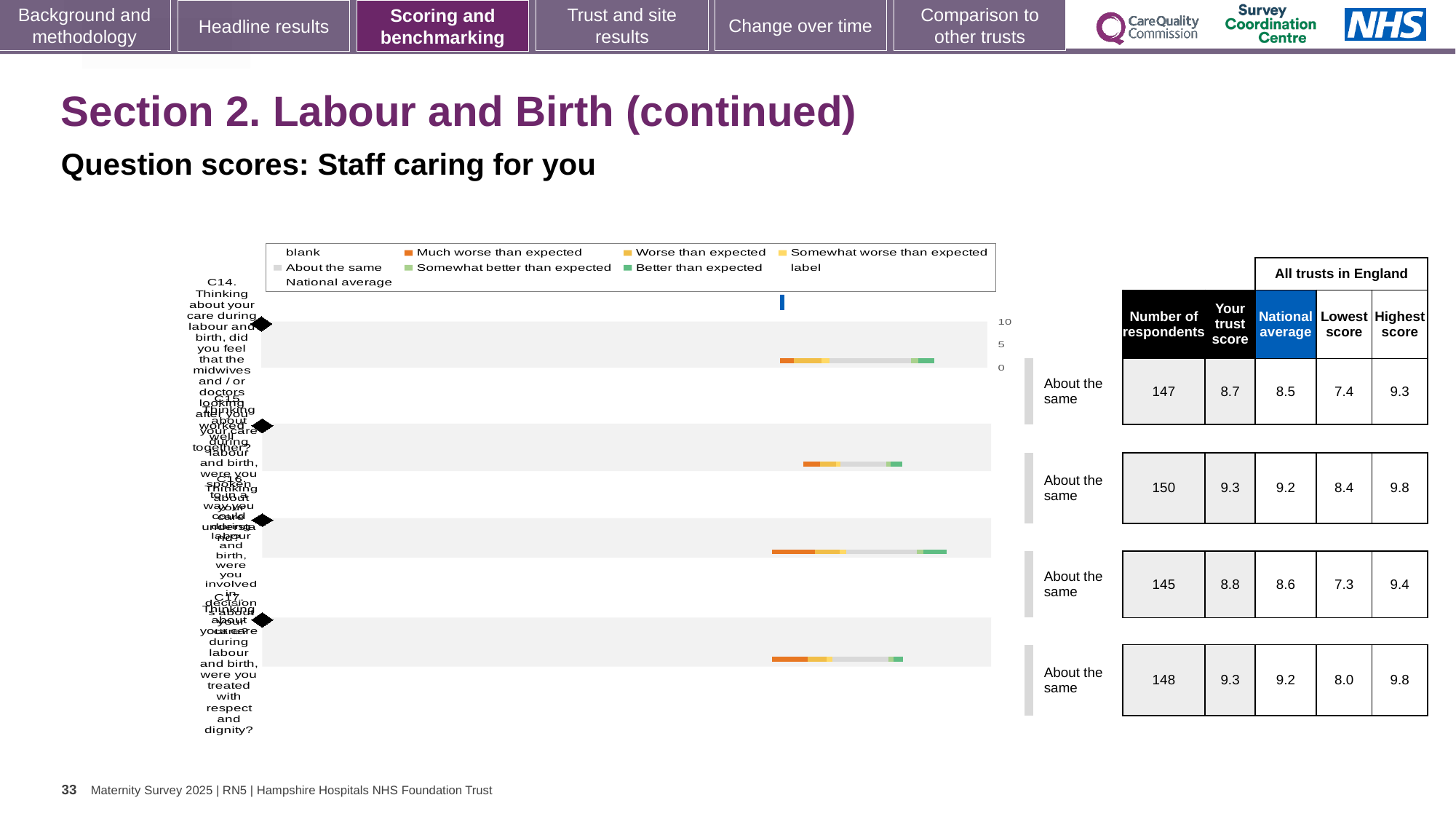
What kind of chart is shown on the slide? bar chart How many question rows (bars) does the chart show? 4 What benchmark label is shown for every question row next to the chart? About the same In the table beside the chart, what is the 'National average' for the row with 145 respondents? 8.6 In the table beside the chart, is the 'Your trust score' for the row with 145 respondents larger or smaller than the 'National average'? larger What is the highest value shown on the chart's axis? 10 In the table beside the chart, which row has the highest 'Lowest score'? the row with 150 respondents (8.4) In the table beside the chart, what is the 'Highest score' for the row with 147 respondents? 9.3 Which colour does the legend use for 'Much worse than expected'? orange In the table beside the chart, what is the 'Your trust score' for the row with 147 respondents? 8.7 In the table beside the chart, what is the difference between 'Your trust score' and 'National average' for the row with 148 respondents? 0.1